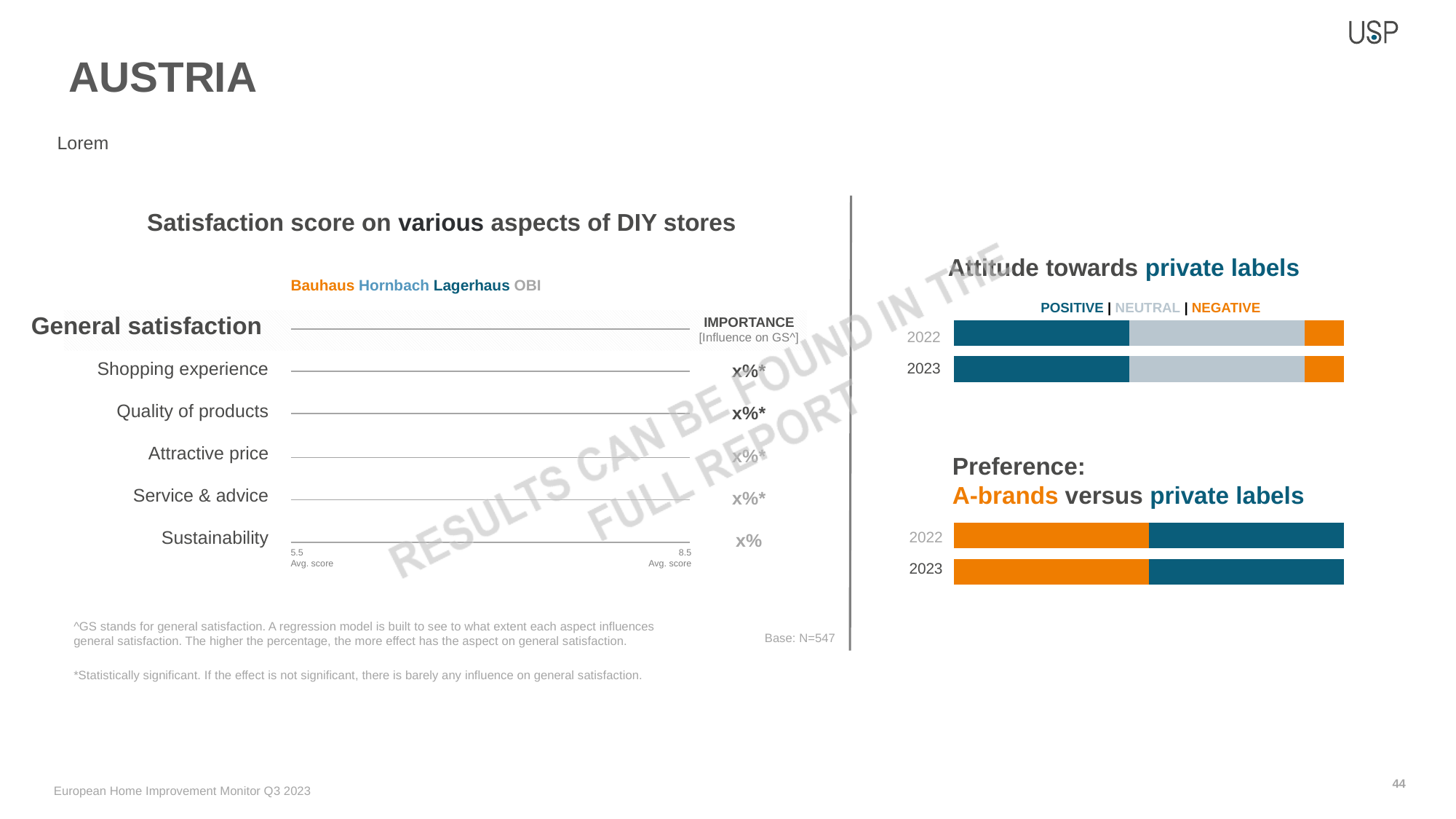
How many aspects are listed below 'General satisfaction' in the 'Satisfaction score on various aspects of DIY stores' chart? 5 How many years are shown in the 'Preference: A-brands versus private labels' chart? 2 In the 'Attitude towards private labels' chart, which segment is larger for 2023: Positive or Negative? Positive What are the minimum and maximum axis values shown on the 'Satisfaction score on various aspects of DIY stores' chart? 5.5 and 8.5 How many store brands does the legend of the 'Satisfaction score on various aspects of DIY stores' chart list? 4 What kind of chart is used for 'Attitude towards private labels'? Stacked bar chart How many years (categories) are shown in the 'Attitude towards private labels' chart? 2 What kind of chart is 'Preference: A-brands versus private labels'? Stacked bar chart How many series does the legend of the 'Attitude towards private labels' chart list? 3 Which colour represents A-brands in the 'Preference: A-brands versus private labels' chart? Orange In the 'Attitude towards private labels' chart, which segment is the smallest for 2022? Negative